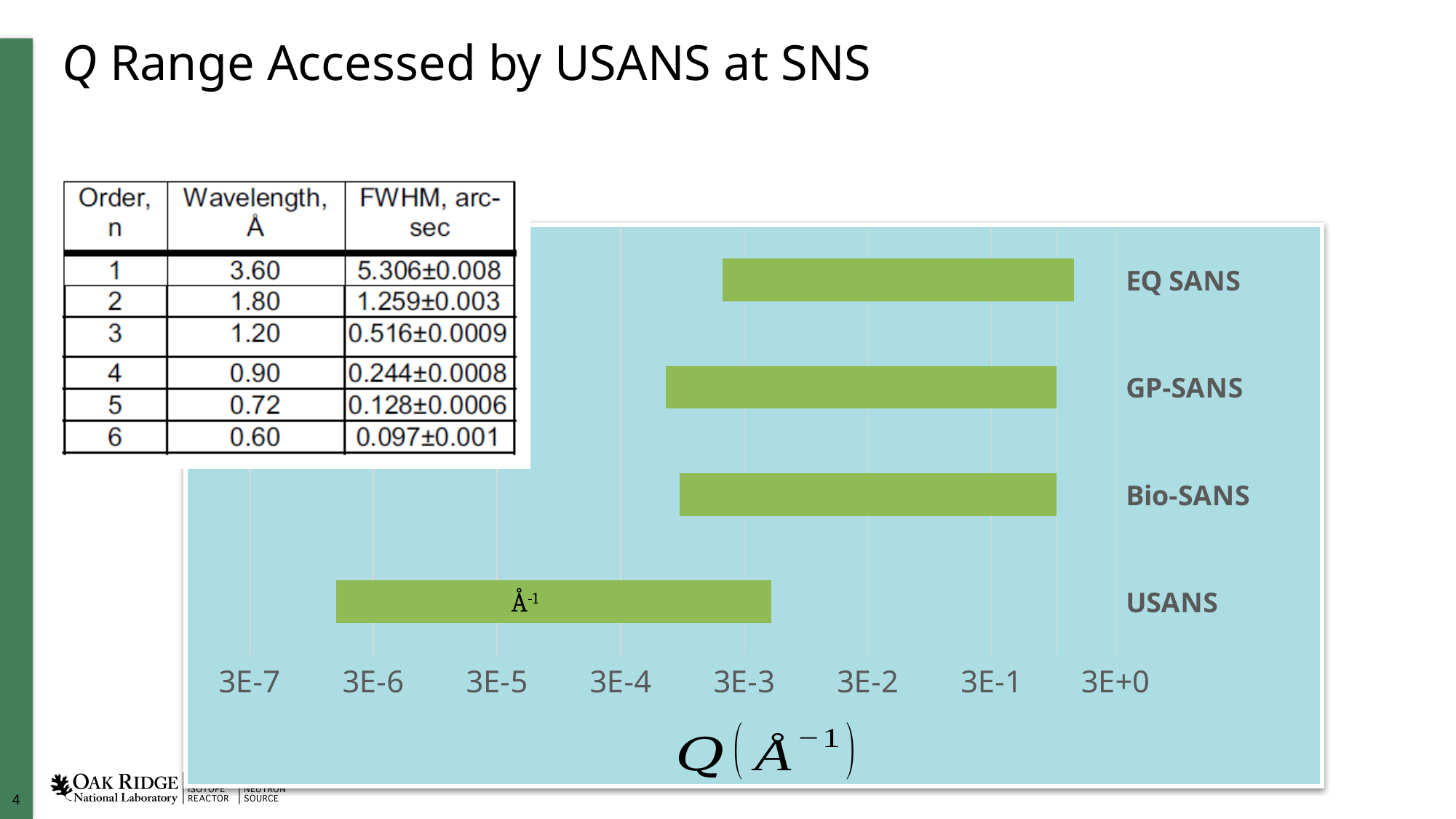
Which instrument covers the widest Q range on the chart? USANS Which instrument's bar extends to the highest Q value? EQ SANS Is the lower end of the GP-SANS bar greater or less than 3E-4? greater Which instrument reaches a higher Q value, EQ SANS or USANS? EQ SANS How many instruments (bars) are shown in the chart? 4 Is the lower end of the USANS bar greater or less than 3E-6? less What is the label of the horizontal axis of the chart? Q (Å⁻¹) Which instrument reaches a lower Q value, USANS or Bio-SANS? USANS What kind of chart is shown on the slide? bar chart Is the upper end of the EQ SANS bar greater or less than 3E-1? greater Which instrument's bar extends to the lowest Q value? USANS